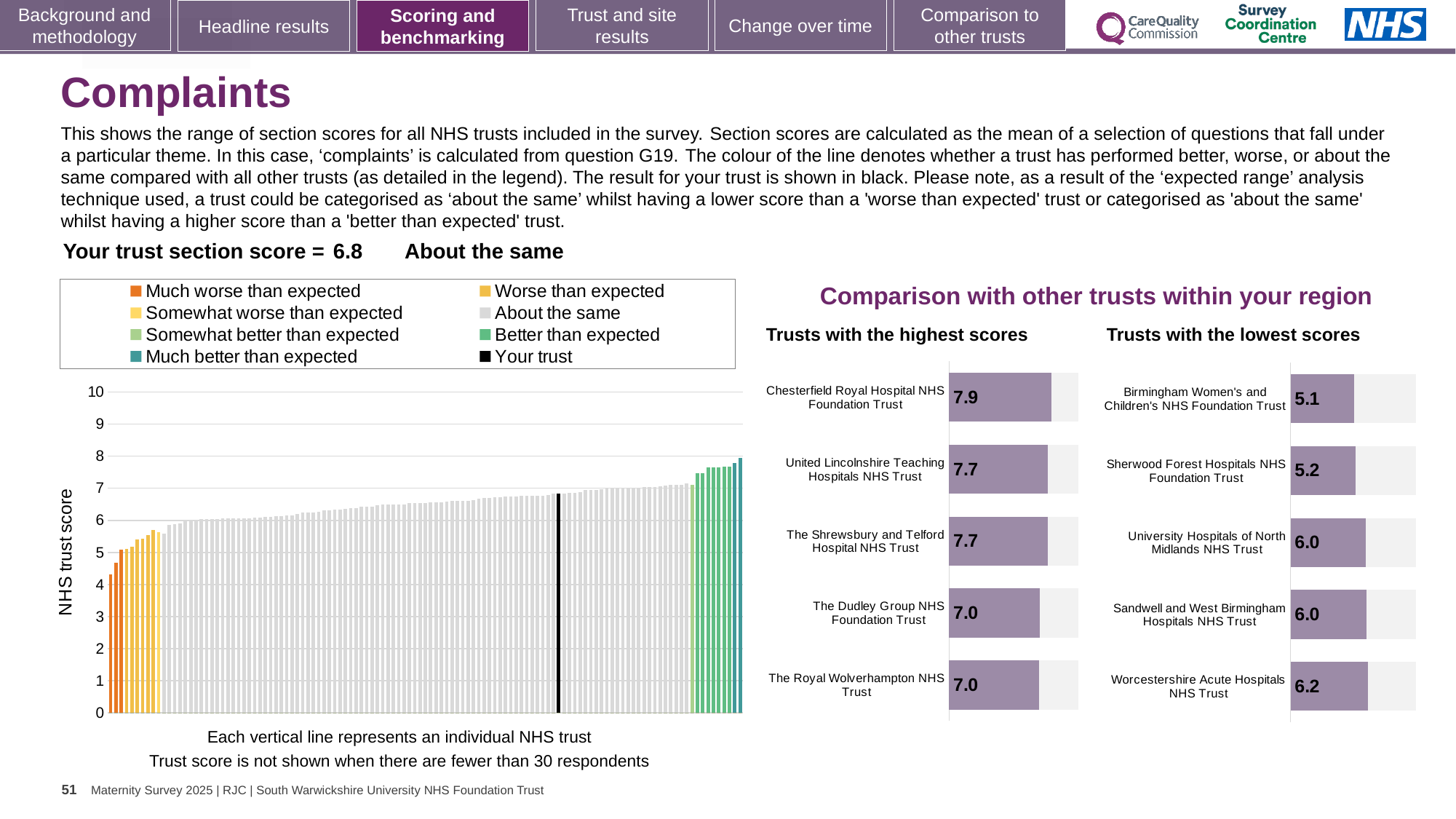
What kind of chart is the large 'NHS trust score' chart on the left? Bar chart In the large 'NHS trust score' chart on the left, is the value of the lowest bar greater or less than 5? less In the 'Trusts with the lowest scores' chart, which has the larger score: Sherwood Forest Hospitals NHS Foundation Trust or Worcestershire Acute Hospitals NHS Trust? Worcestershire Acute Hospitals NHS Trust How many trusts are shown in the 'Trusts with the highest scores' chart? 5 In the large 'NHS trust score' chart on the left, is the value of the black bar for your trust greater or less than 6? greater How many entries does the legend of the large 'NHS trust score' chart on the left list? 8 In the 'Trusts with the lowest scores' chart, what is the difference between the scores of Worcestershire Acute Hospitals NHS Trust and Birmingham Women's and Children's NHS Foundation Trust? 1.1 In the 'Trusts with the highest scores' chart, what is the difference between the scores of Chesterfield Royal Hospital NHS Foundation Trust and The Dudley Group NHS Foundation Trust? 0.9 In the 'Trusts with the highest scores' chart, what is the score for Chesterfield Royal Hospital NHS Foundation Trust? 7.9 In the 'Trusts with the lowest scores' chart, what is the score for Sherwood Forest Hospitals NHS Foundation Trust? 5.2 In the 'Trusts with the highest scores' chart, which trust has the highest score? Chesterfield Royal Hospital NHS Foundation Trust In the 'Trusts with the lowest scores' chart, which trust has the lowest score? Birmingham Women's and Children's NHS Foundation Trust